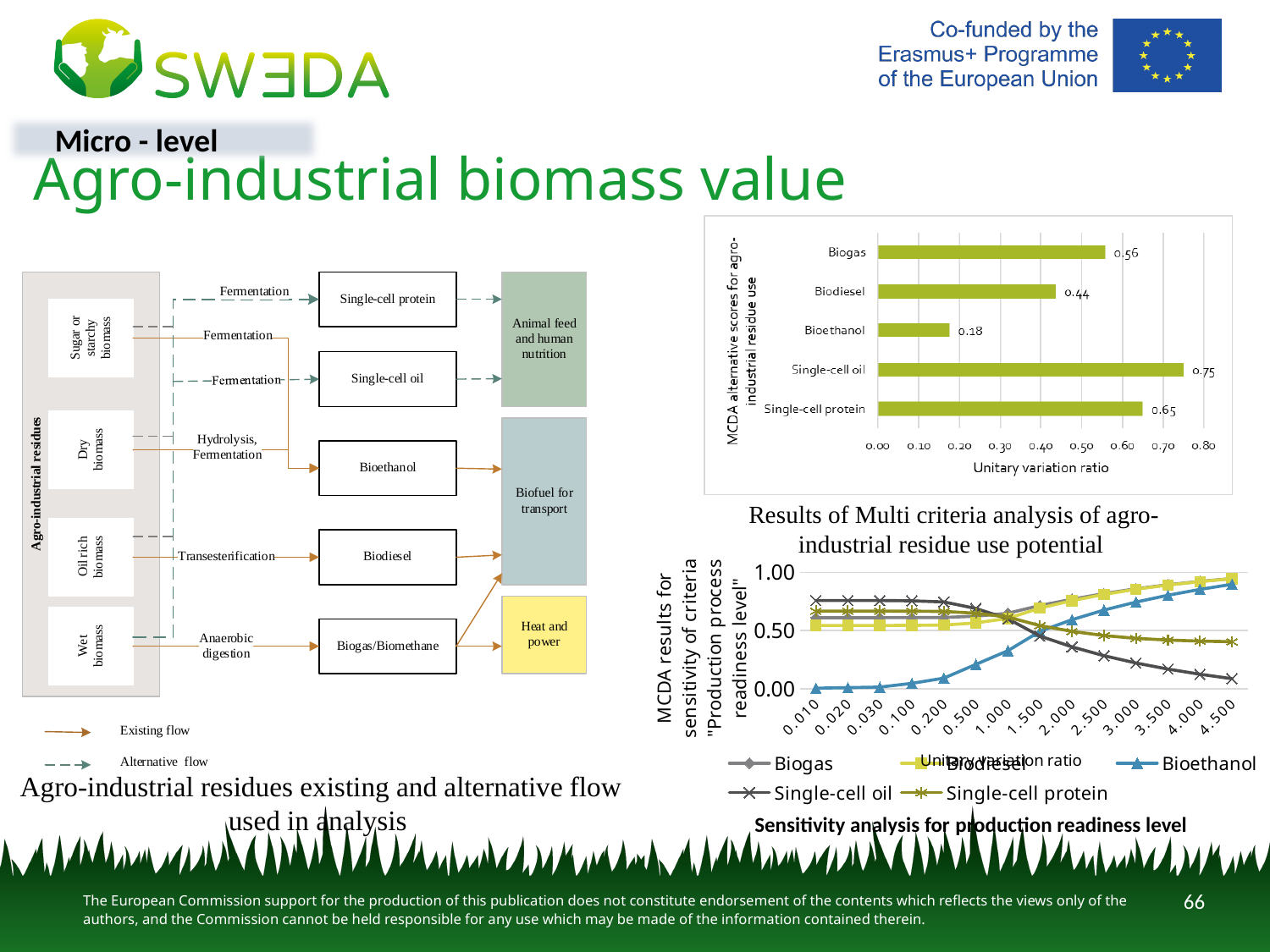
In the bar chart at the top right, which has a higher score, Biogas or Biodiesel? Biogas How many categories are shown in the bar chart at the top right? 5 How many series does the legend of the Sensitivity analysis line chart at the bottom right list? 5 In the bar chart at the top right, what is the score for Single-cell oil? 0.75 In the bar chart at the top right, what is the difference between the scores for Single-cell protein and Biodiesel? 0.21 In the Sensitivity analysis line chart at the bottom right, does the Bioethanol series rise or fall as the unitary variation ratio increases? Rises In the Sensitivity analysis line chart at the bottom right, does the Biogas series rise or fall as the unitary variation ratio increases? Rises In the bar chart at the top right (Results of Multi criteria analysis), what is the MCDA alternative score for Biogas? 0.56 What type of chart is the chart at the top right of the slide? Bar chart In the bar chart at the top right, which category has the highest score? Single-cell oil In the bar chart at the top right, what is the score for Bioethanol? 0.18 In the bar chart at the top right, which category has the lowest score? Bioethanol